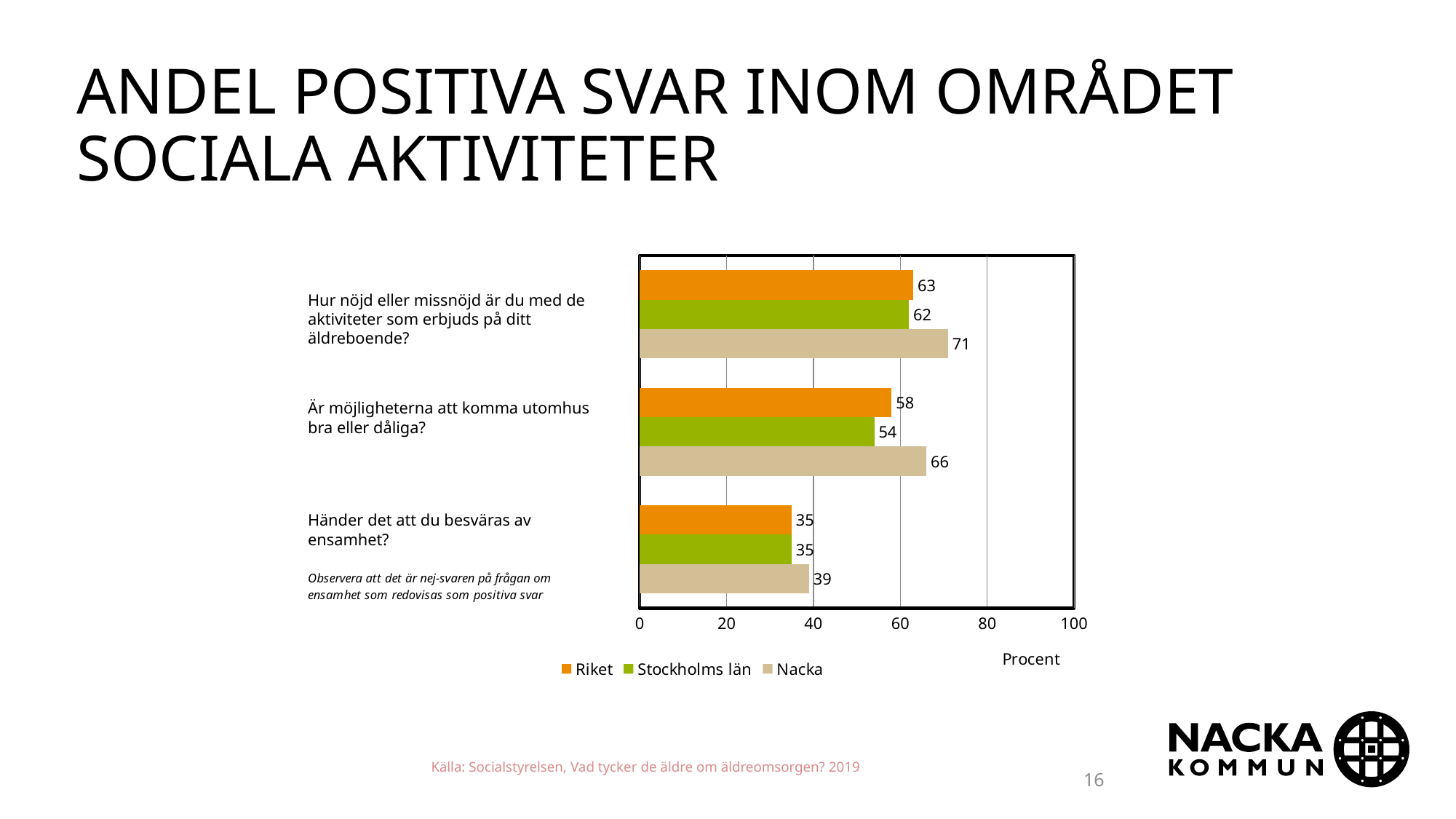
What is the value for Riket on the question "Är möjligheterna att komma utomhus bra eller dåliga?"? 58 What is the value for Nacka on the question "Hur nöjd eller missnöjd är du med de aktiviteter som erbjuds på ditt äldreboende?"? 71 How many questions (categories) are shown on the chart? 3 What is the difference between the Nacka and Stockholms län values on the question "Är möjligheterna att komma utomhus bra eller dåliga?"? 12 Is the value for Nacka on the question "Händer det att du besväras av ensamhet?" greater or less than 40? less What is the label on the horizontal axis of the chart? Procent Which question has the lowest value for Nacka? Händer det att du besväras av ensamhet? What is the value for Stockholms län on the question "Händer det att du besväras av ensamhet?"? 35 Which is larger: the Riket value or the Stockholms län value on the question "Hur nöjd eller missnöjd är du med de aktiviteter som erbjuds på ditt äldreboende?"? Riket Which series has the highest value on the question "Är möjligheterna att komma utomhus bra eller dåliga?"? Nacka How many series does the legend list? 3 What kind of chart is shown on the slide? Bar chart